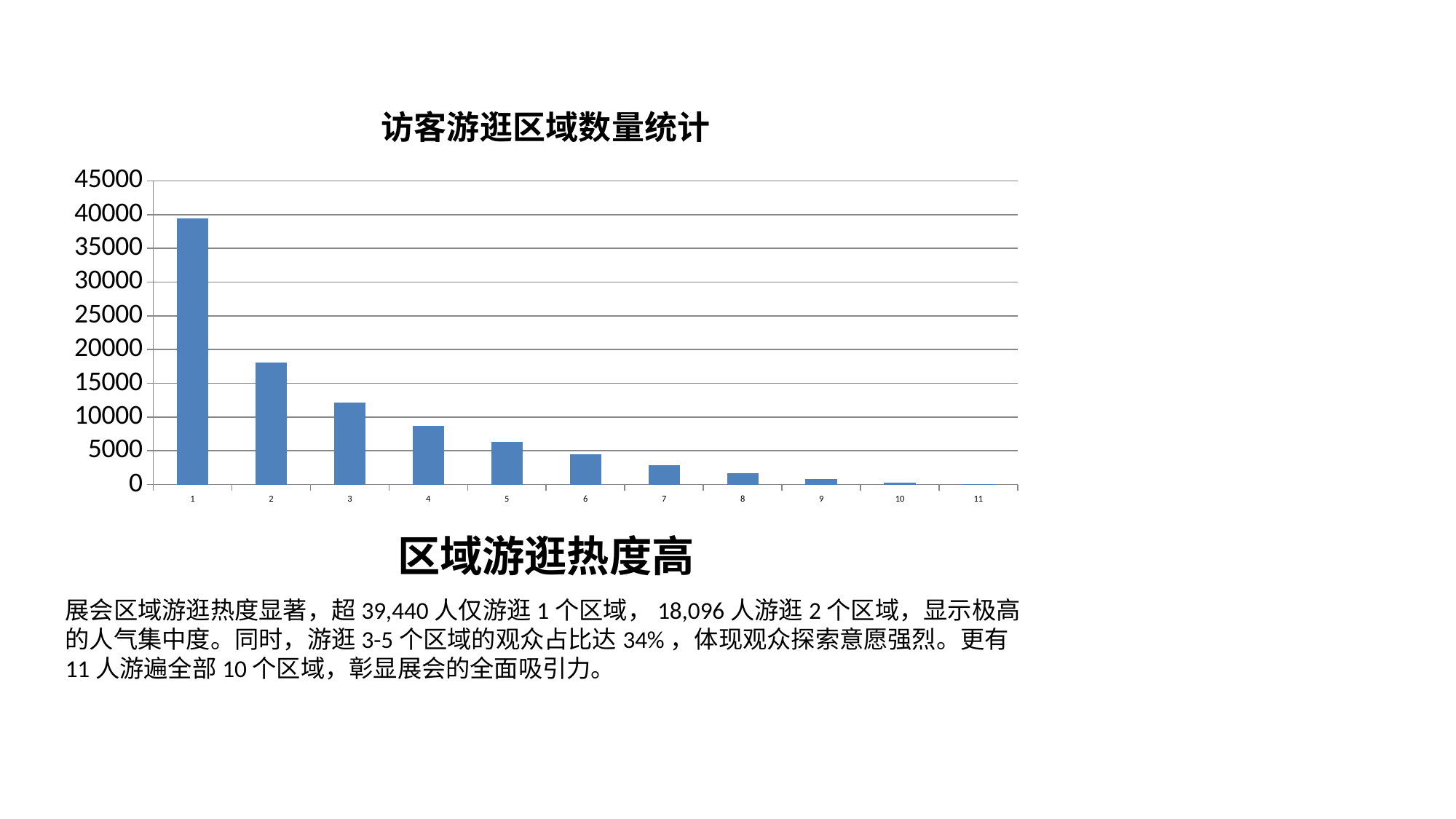
Is the value for category 2 greater or less than 15000? greater Which category has the highest value in the chart? 1 Is the value for category 6 greater or less than 5000? less Do the values rise or fall as you move from category 1 to category 10 along the x axis? fall Which has the larger value, category 2 or category 3? 2 Which has the larger value, category 5 or category 7? 5 Is the value for category 1 greater or less than 35000? greater What kind of chart is shown on the slide? bar chart How many categories are shown on the x axis of the chart? 11 What is the title of the chart? 访客游逛区域数量统计